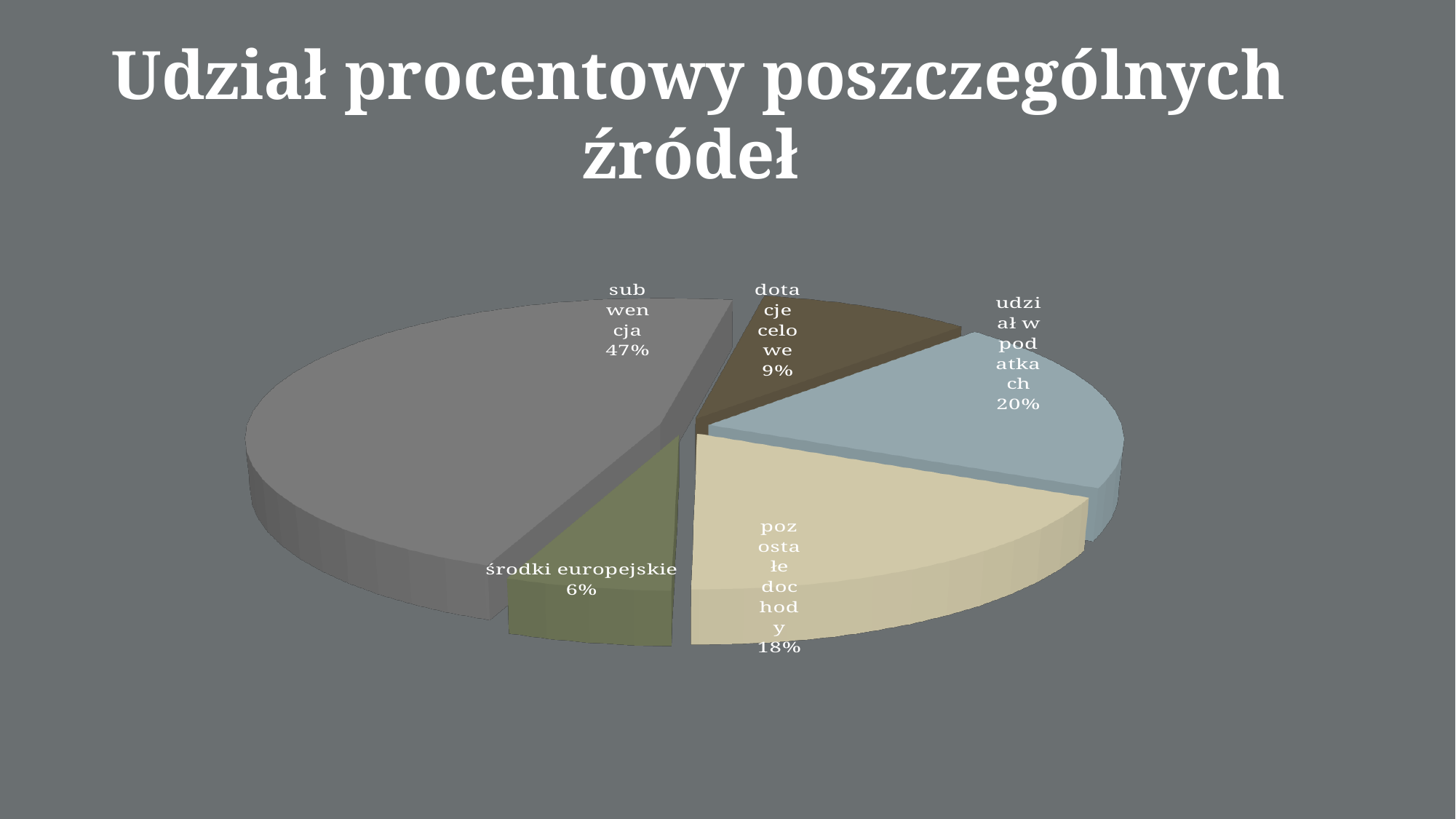
How many slices does the pie chart have? 5 What percentage is shown for pozostałe dochody? 18% What percentage is shown for środki europejskie? 6% Which is larger, the share for dotacje celowe or the share for środki europejskie? dotacje celowe What share of the pie does subwencja have? 47% Which source has the largest share of the pie? subwencja What kind of chart is shown on the slide? pie chart What is the difference in percentage points between subwencja and udział w podatkach? 27 Which source has the smallest share of the pie? środki europejskie What percentage is shown for dotacje celowe? 9% What percentage is shown for udział w podatkach? 20% What is the title of the slide? Udział procentowy poszczególnych źródeł